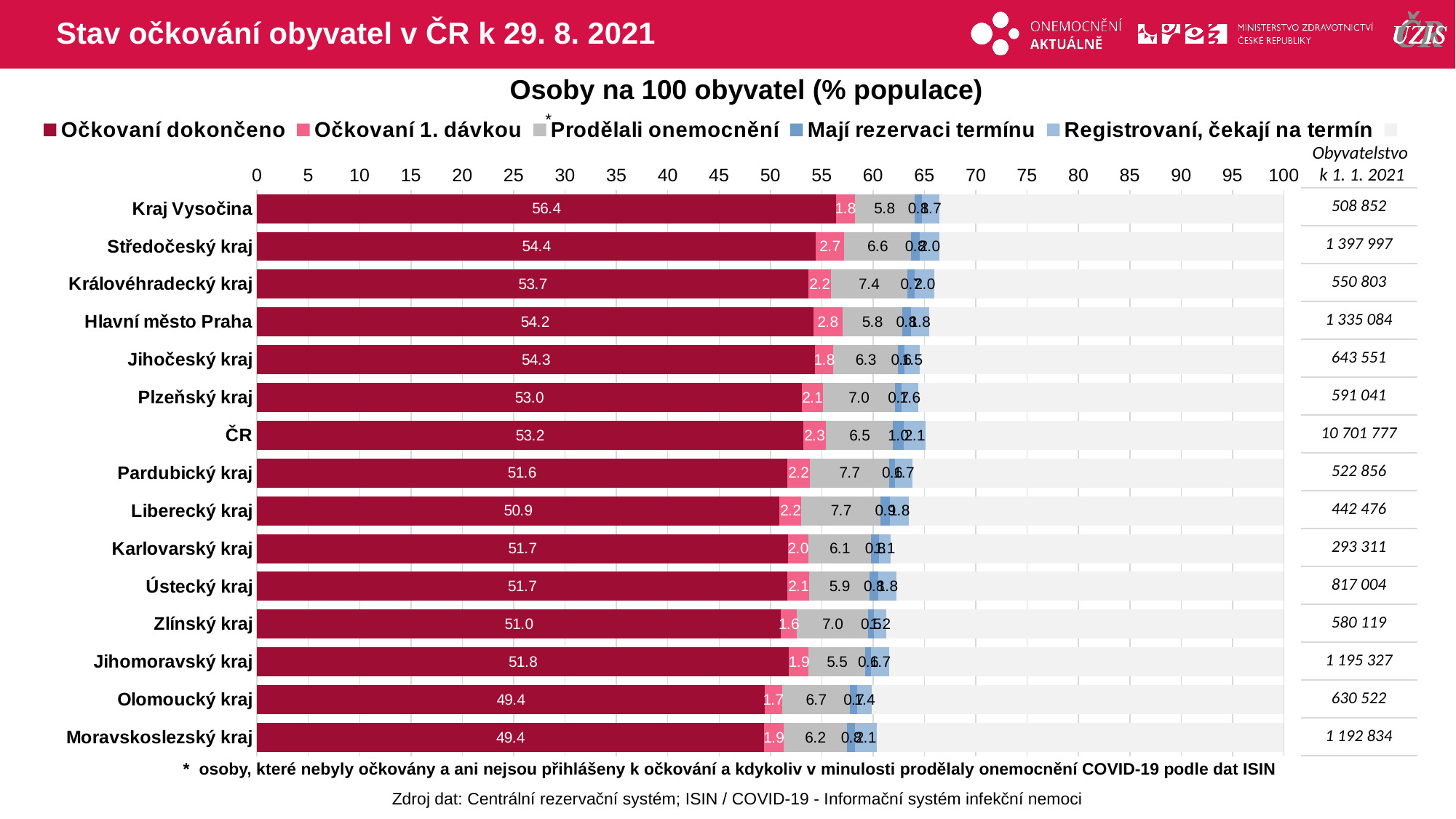
What is the title of the chart? Osoby na 100 obyvatel (% populace) Which region has the highest value for 'Očkovaní dokončeno'? Kraj Vysočina Which has a larger 'Prodělali onemocnění' value, Královéhradecký kraj or Hlavní město Praha? Královéhradecký kraj Is the 'Očkovaní dokončeno' value for Kraj Vysočina greater or less than 55? greater What is the value of 'Očkovaní dokončeno' for Kraj Vysočina? 56.4 How many regions (categories) are plotted in the chart? 15 What type of chart is shown on the slide? Stacked bar chart What is the value of 'Očkovaní 1. dávkou' for Hlavní město Praha? 2.8 What is the difference in 'Očkovaní dokončeno' between Kraj Vysočina and Středočeský kraj? 2.0 Is the 'Očkovaní dokončeno' value for Olomoucký kraj greater or less than 50? less What is the value of 'Očkovaní dokončeno' for ČR? 53.2 What is the value of 'Prodělali onemocnění' for Královéhradecký kraj? 7.4